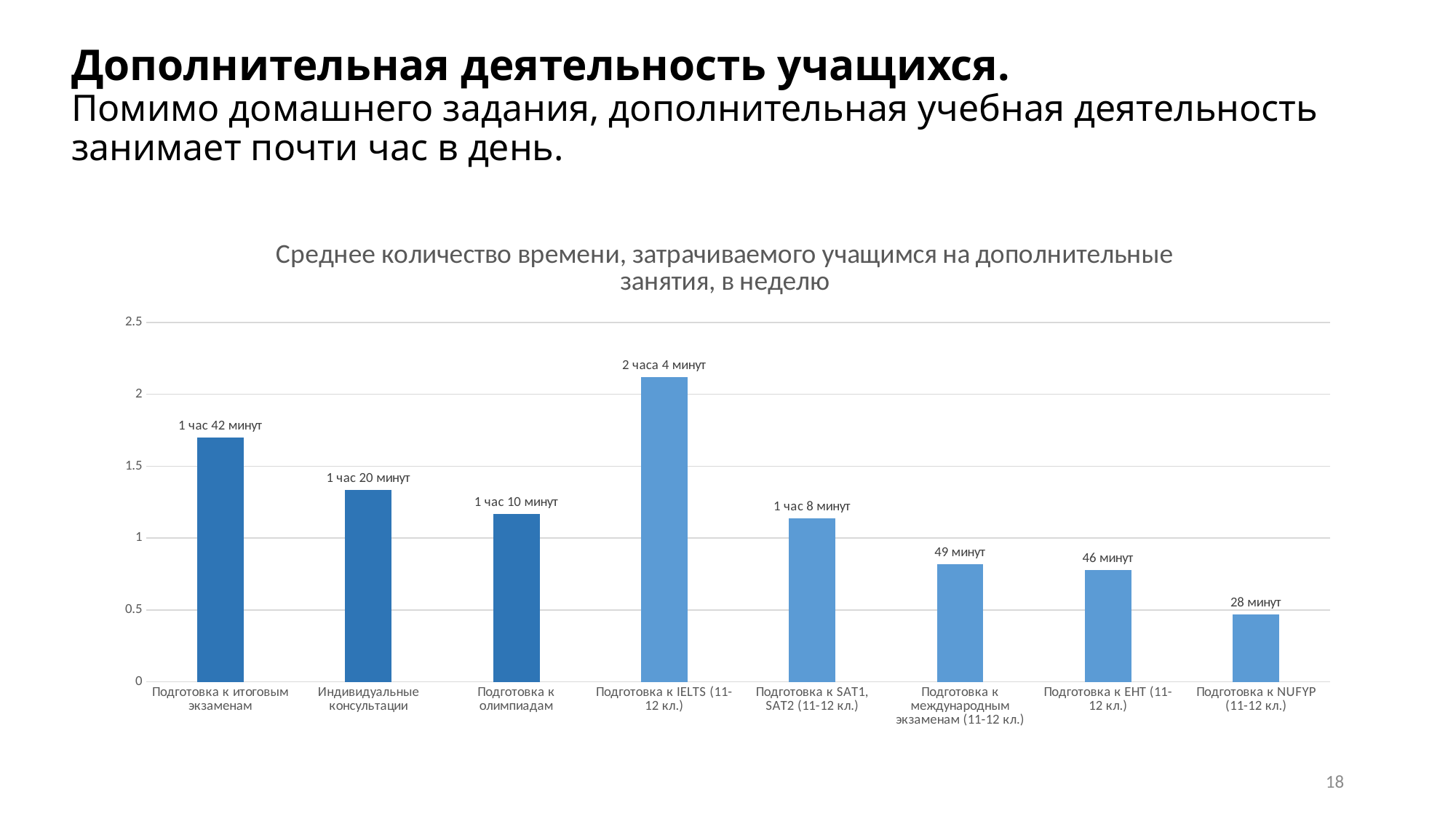
What is the value for Подготовка к ЕНТ (11-12 кл.)? 46 минут What is the difference between the value for Подготовка к итоговым экзаменам and the value for Индивидуальные консультации? 22 минуты What is the value for Подготовка к IELTS (11-12 кл.)? 2 часа 4 минут Which category has the lowest value? Подготовка к NUFYP (11-12 кл.) Is the value for Подготовка к олимпиадам greater or less than 1? greater What is the value for Подготовка к NUFYP (11-12 кл.)? 28 минут Which is larger: the value for Подготовка к итоговым экзаменам or the value for Подготовка к олимпиадам? Подготовка к итоговым экзаменам How many categories are shown on the x axis of the chart? 8 What is the title of the chart? Среднее количество времени, затрачиваемого учащимся на дополнительные занятия, в неделю What kind of chart is shown on the slide? Bar chart Which category has the highest value? Подготовка к IELTS (11-12 кл.) What is the value for Индивидуальные консультации? 1 час 20 минут